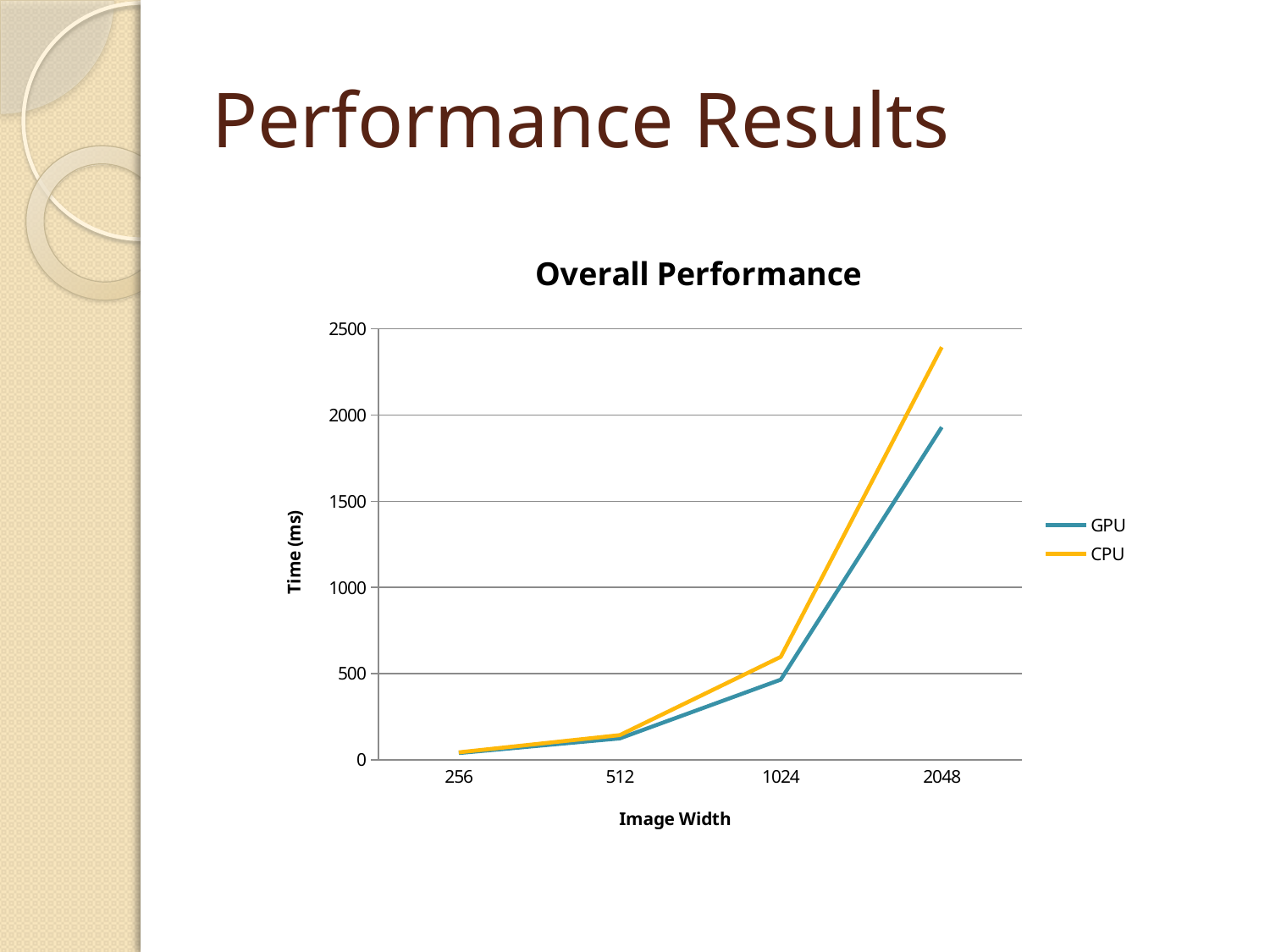
Is the CPU value at image width 2048 greater or less than 2000? greater What kind of chart is shown on the slide? line chart Is the GPU value at image width 2048 greater or less than 2000? less Is the CPU value at image width 1024 greater or less than 500? greater What is the label of the y axis? Time (ms) Which series has the higher value at image width 2048, GPU or CPU? CPU What is the title of the chart? Overall Performance How many series does the legend list? 2 How many image width categories are plotted on the x axis? 4 At which image width does the CPU series reach its highest value? 2048 Do the GPU values rise or fall as image width increases along the x axis? rise